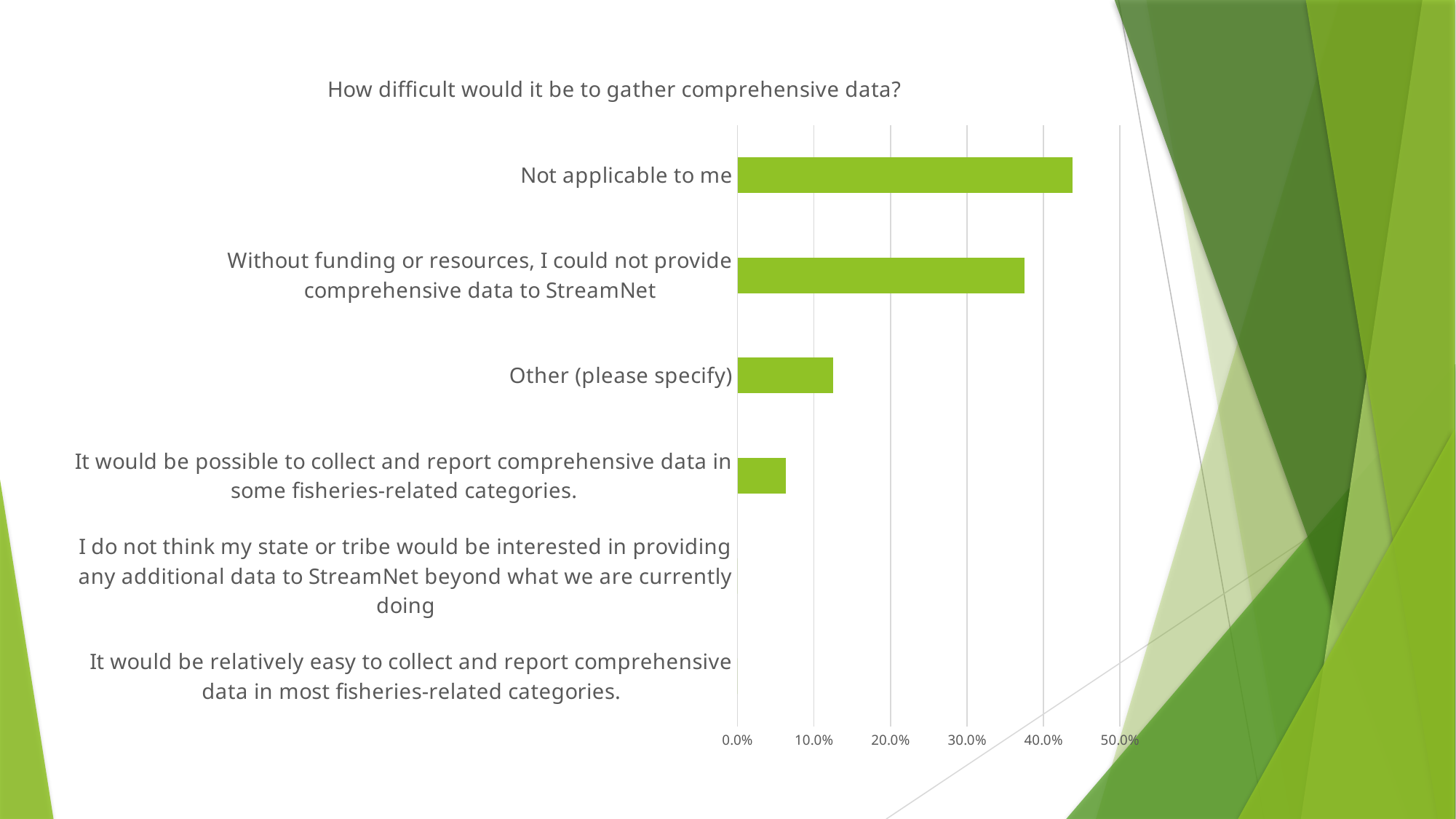
Which category has the highest value? Not applicable to me What kind of chart is shown on the slide? bar chart Which is larger: the value for "Other (please specify)" or the value for "It would be possible to collect and report comprehensive data in some fisheries-related categories."? Other (please specify) How many categories are listed on the chart's vertical axis? 6 Which is larger: the value for "Not applicable to me" or the value for "Without funding or resources, I could not provide comprehensive data to StreamNet"? Not applicable to me Is the value for "Without funding or resources, I could not provide comprehensive data to StreamNet" greater or less than 40.0%? less What is the title of the chart? How difficult would it be to gather comprehensive data? Is the value for "Without funding or resources, I could not provide comprehensive data to StreamNet" greater or less than 30.0%? greater Is the value for "Not applicable to me" greater or less than 40.0%? greater What is the highest tick label shown on the horizontal axis? 50.0%